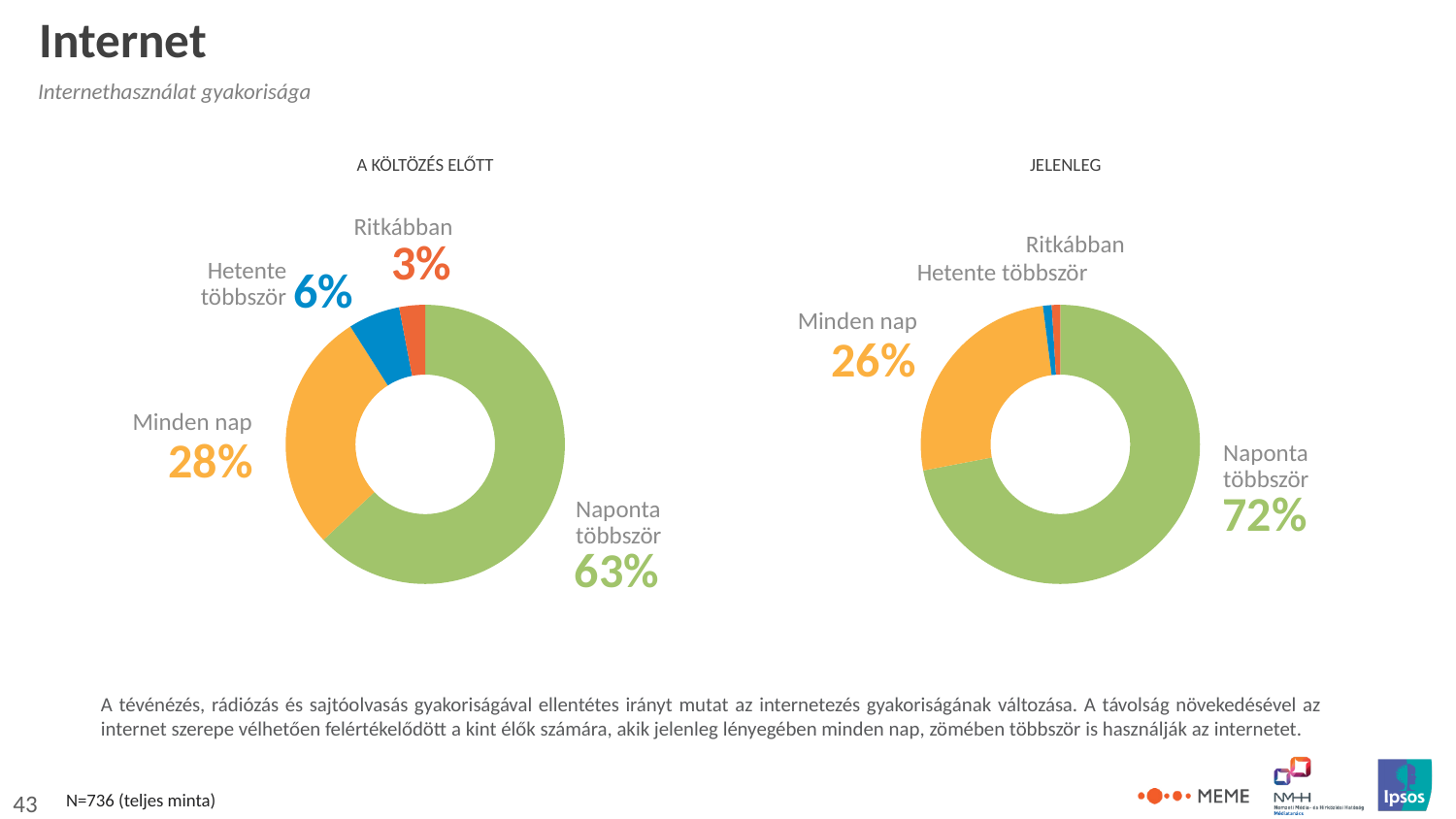
In the "A KÖLTÖZÉS ELŐTT" chart, what share is shown for "Hetente többször"? 6% In the "JELENLEG" chart, which category has the largest share? Naponta többször In the "A KÖLTÖZÉS ELŐTT" chart, what share is shown for "Minden nap"? 28% In the "A KÖLTÖZÉS ELŐTT" chart, which category has the smallest share? Ritkábban How many categories are shown in the "A KÖLTÖZÉS ELŐTT" chart? 4 In the "A KÖLTÖZÉS ELŐTT" chart, what share is shown for "Ritkábban"? 3% What is the difference between the "Naponta többször" share in the "JELENLEG" chart and in the "A KÖLTÖZÉS ELŐTT" chart? 9 percentage points In the "JELENLEG" chart, what share is shown for "Minden nap"? 26% In the "JELENLEG" chart, what share is shown for "Naponta többször"? 72% In the "A KÖLTÖZÉS ELŐTT" chart, what share is shown for "Naponta többször"? 63% What type of chart is used on this slide? Donut (pie) chart In the "A KÖLTÖZÉS ELŐTT" chart, which category has the largest share? Naponta többször